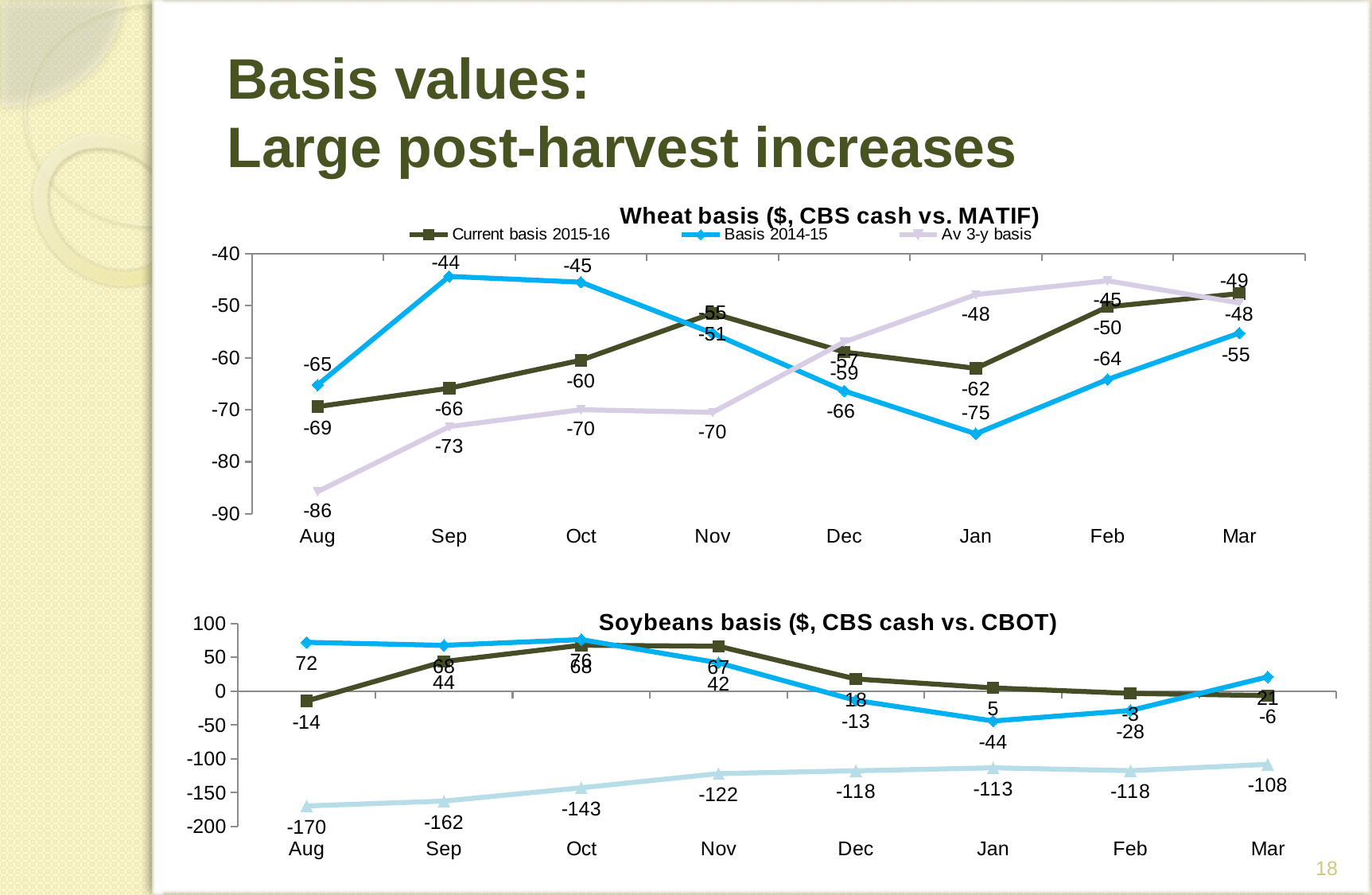
What kind of chart is the Soybeans basis chart? Line chart In the Soybeans basis chart, in which month is the Basis 2014-15 series highest? Oct In the Soybeans basis chart, what is the Basis 2014-15 value for Jan? -44 In the Wheat basis chart, what is the Basis 2014-15 value for Jan? -75 In the Soybeans basis chart, which is larger in Nov: the Current basis 2015-16 value or the Basis 2014-15 value? Current basis 2015-16 How many series does the legend of the Wheat basis chart list? 3 In the Wheat basis chart, what is the Current basis 2015-16 value for Aug? -69 How many months are plotted on the x axis of the Soybeans basis chart? 8 In the Soybeans basis chart, what is the Av 3-y basis value for Aug? -170 In the Wheat basis chart, what is the Av 3-y basis value for Aug? -86 In the Wheat basis chart, what is the difference between the Basis 2014-15 value and the Current basis 2015-16 value in Sep? 22 In the Wheat basis chart, in which month is the Av 3-y basis lowest? Aug